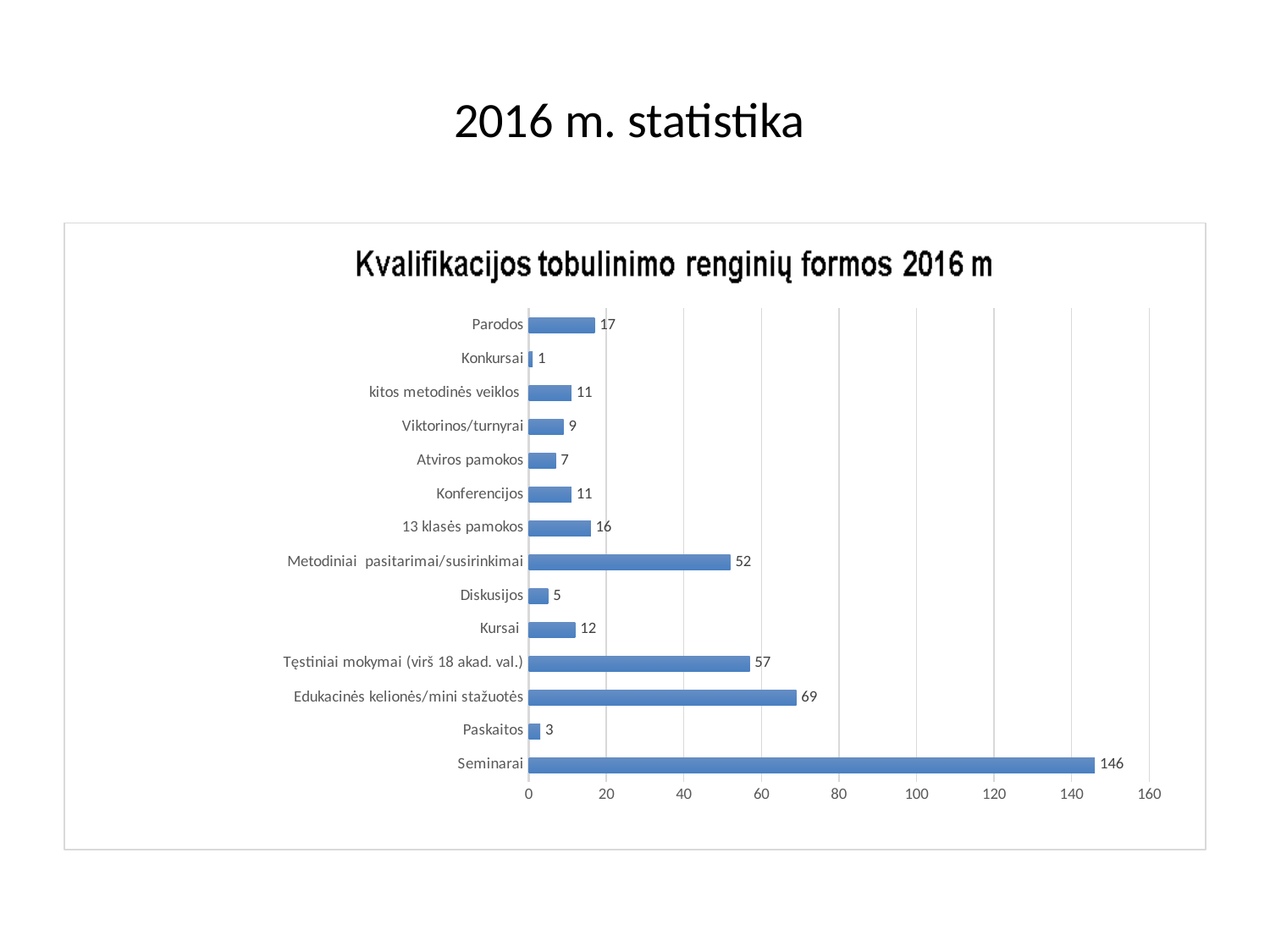
What is the value for Edukacinės kelionės/mini stažuotės? 69 Is the value for Seminarai greater or less than 140? greater What is the difference between the values for Seminarai and Edukacinės kelionės/mini stažuotės? 77 How many categories are shown in the chart? 14 What is the value for Seminarai? 146 Which is larger, the value for Tęstiniai mokymai (virš 18 akad. val.) or the value for Metodiniai pasitarimai/susirinkimai? Tęstiniai mokymai (virš 18 akad. val.) Which category has the highest value? Seminarai What is the title of the chart? Kvalifikacijos tobulinimo renginių formos 2016 m What kind of chart is shown on the slide? bar chart What is the value for Metodiniai pasitarimai/susirinkimai? 52 Which category has the lowest value? Konkursai What is the value for Paskaitos? 3